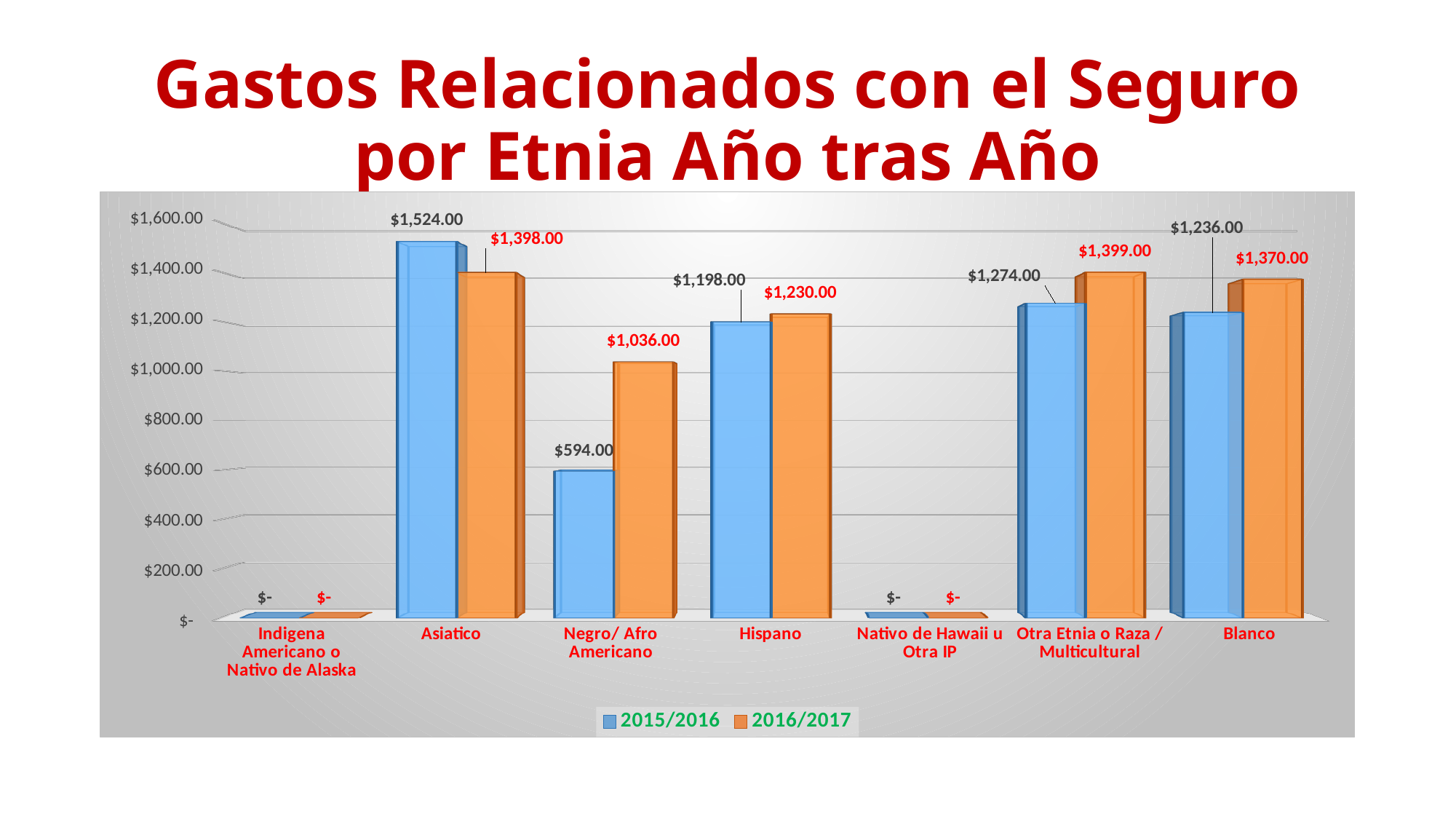
Which is larger for Asiatico, the 2015/2016 value or the 2016/2017 value? 2015/2016 Which category has the highest 2015/2016 value? Asiatico What is the 2015/2016 value for Asiatico? $1,524.00 What is the 2016/2017 value for Blanco? $1,370.00 How many series does the legend list? 2 What is the 2016/2017 value for Negro/ Afro Americano? $1,036.00 Which category has the highest 2016/2017 value? Otra Etnia o Raza / Multicultural Is the 2015/2016 value for Otra Etnia o Raza / Multicultural greater or less than $1,200.00? greater What is the 2015/2016 value for Hispano? $1,198.00 What is the difference between the 2016/2017 and 2015/2016 values for Negro/ Afro Americano? $442.00 How many categories are shown on the x axis? 7 What kind of chart is shown on the slide? bar chart